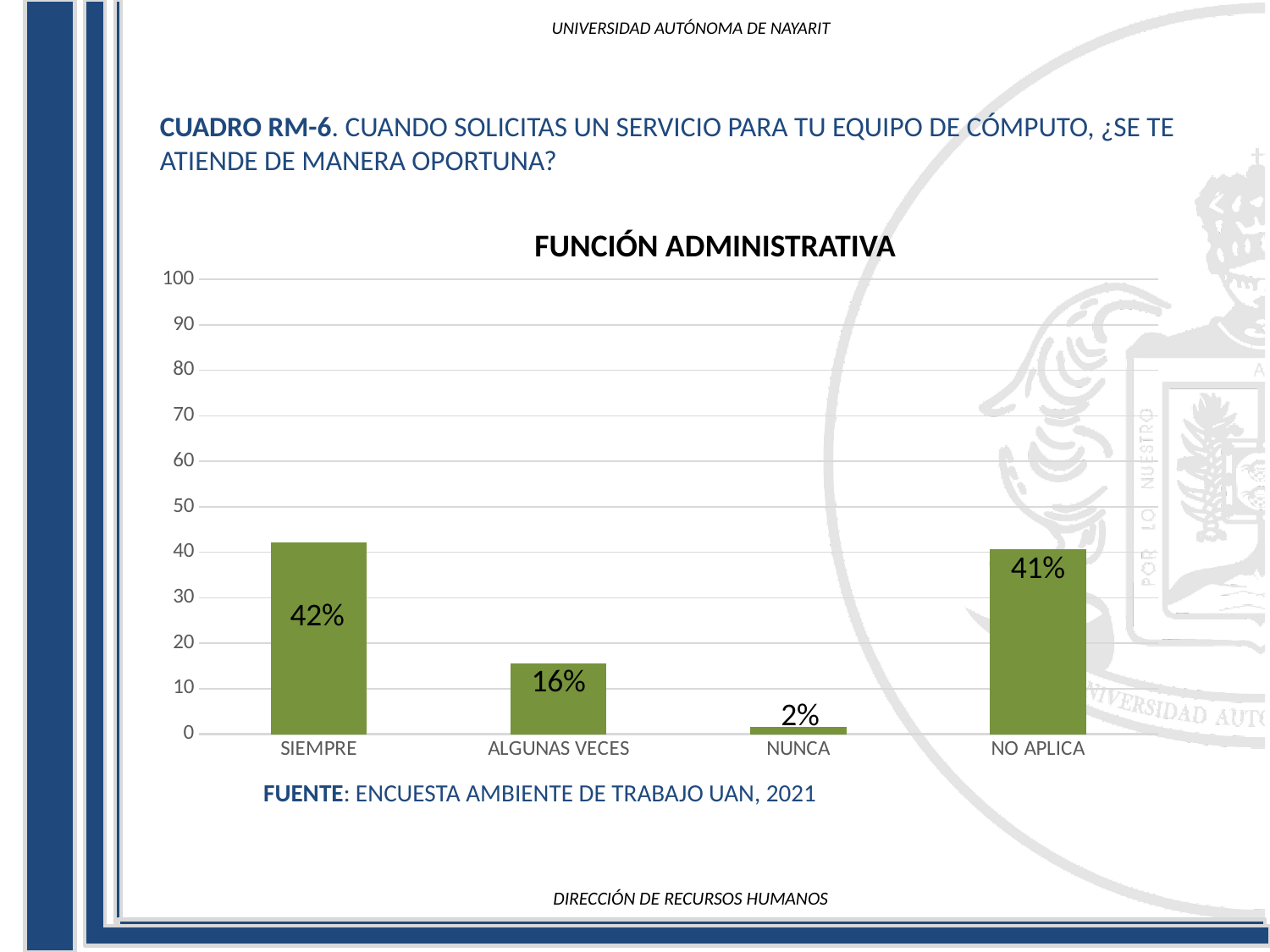
What is the value for NUNCA? 2% What is the difference between the values for SIEMPRE and ALGUNAS VECES? 26% What is the value for NO APLICA? 41% Which category has the highest value? SIEMPRE What kind of chart is shown on the slide? bar chart What is the value for SIEMPRE? 42% What is the title of the chart? FUNCIÓN ADMINISTRATIVA How many categories are shown on the x axis? 4 Which category has the lowest value? NUNCA What is the difference between the values for NO APLICA and NUNCA? 39% What is the value for ALGUNAS VECES? 16% Which is larger, the value for ALGUNAS VECES or the value for NO APLICA? NO APLICA